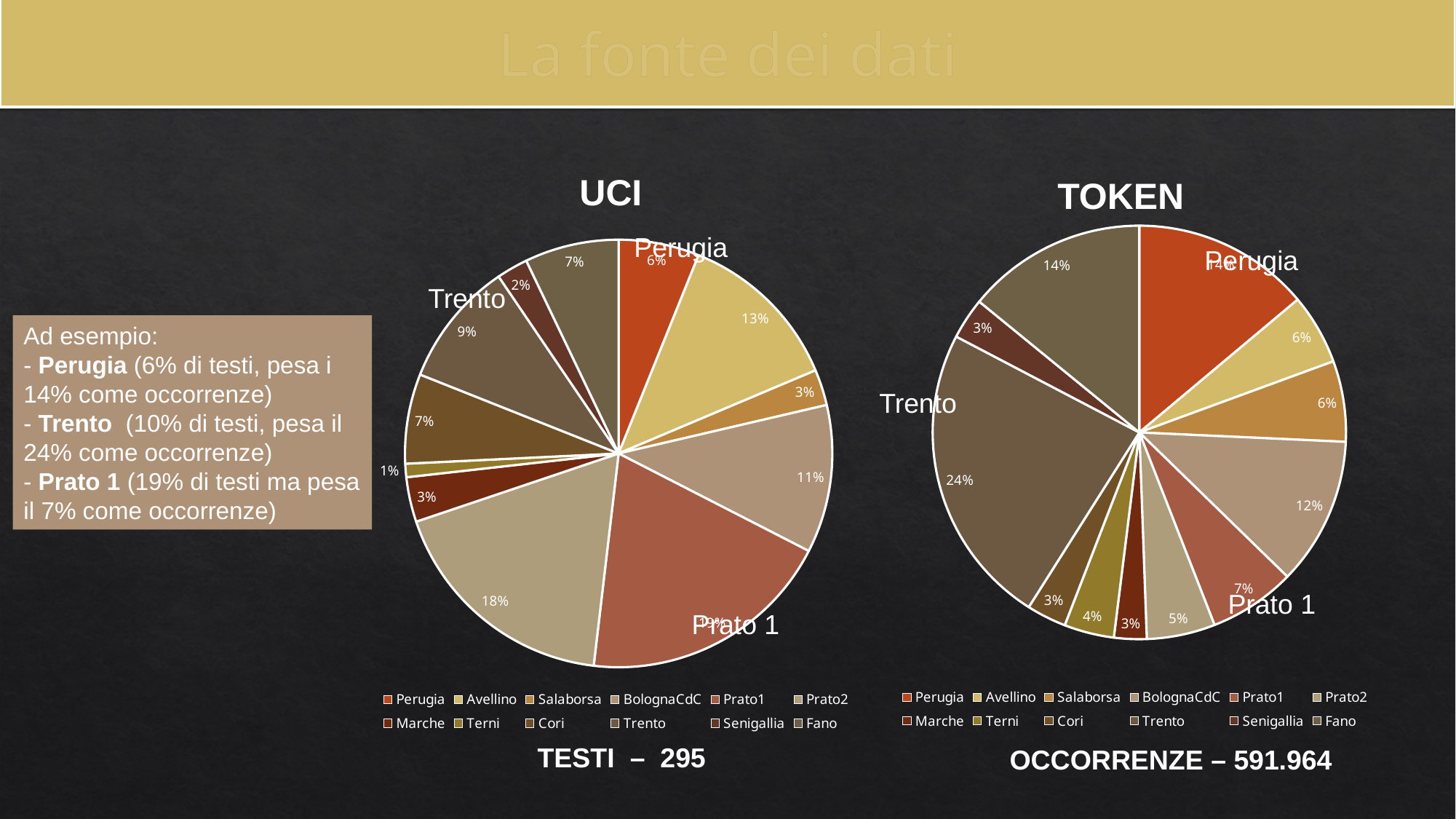
What kind of chart is the UCI chart? pie chart What is the title of the pie chart on the right? TOKEN In the UCI chart, what percentage does the Perugia slice show? 6% In the UCI chart, what percentage does the Trento slice show? 9% In the TOKEN chart, what percentage does the Trento slice show? 24% In the TOKEN chart, which is larger, the Trento slice or the Perugia slice? Trento How many categories does the legend of the UCI chart list? 12 What total number of texts (TESTI) is shown under the UCI chart? 295 In the TOKEN chart, which labelled slice is the largest? Trento In the TOKEN chart, what is the difference in percentage points between the Trento slice (24%) and the Perugia slice (14%)? 10 In the UCI chart, is the Prato 2 slice (18%) greater or less than the Perugia slice (6%)? greater